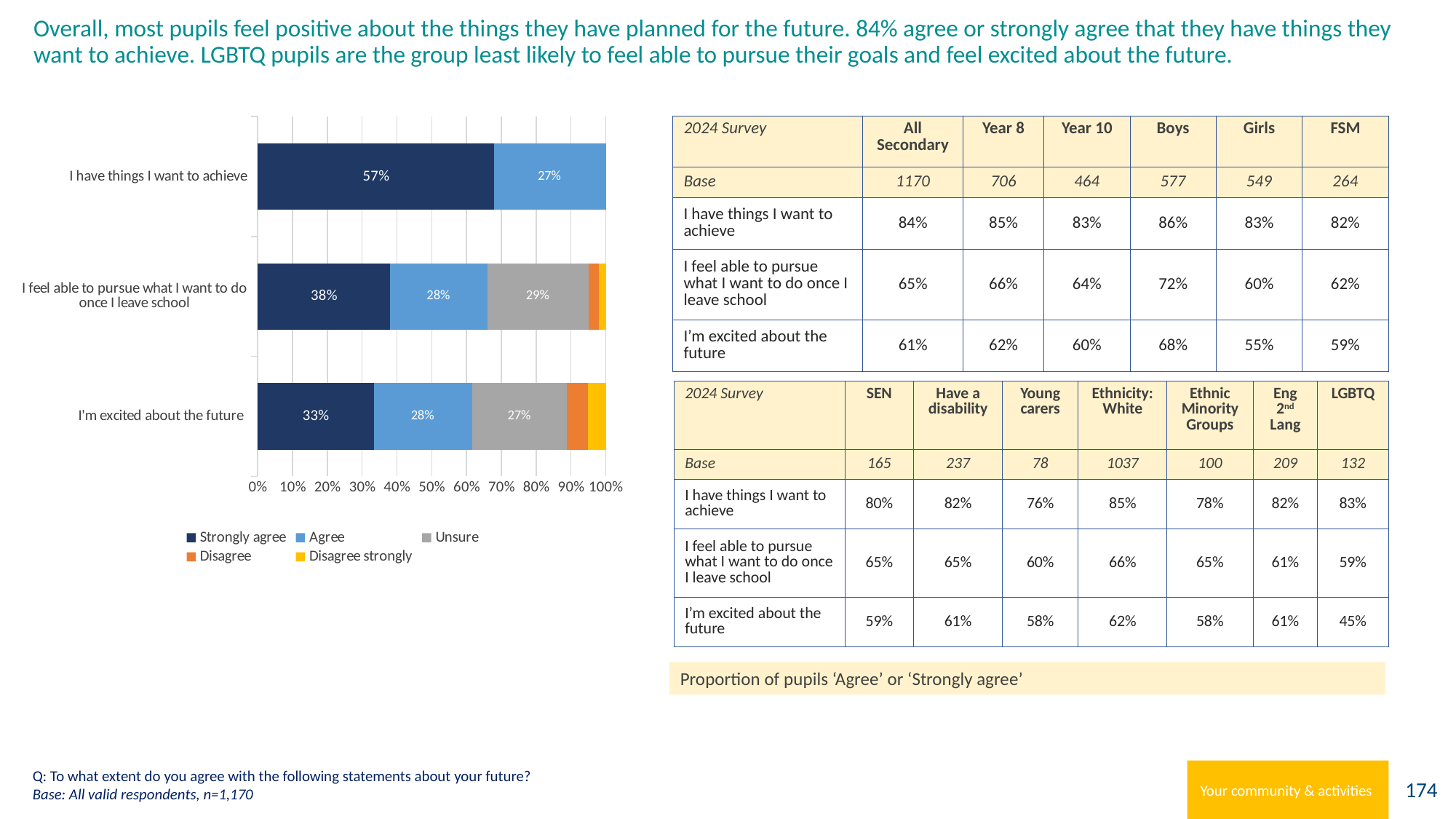
Which statement has the highest 'Strongly agree' value? I have things I want to achieve Is the 'Strongly agree' value for 'I have things I want to achieve' greater or less than 50%? greater How many series does the chart legend list? 5 Which statement has the lowest 'Strongly agree' value? I'm excited about the future What is the 'Strongly agree' value for 'I'm excited about the future'? 33% What percentage of pupils strongly agree that they have things they want to achieve? 57% What is the 'Unsure' value for 'I'm excited about the future'? 27% What is the difference between the 'Strongly agree' values for 'I have things I want to achieve' and 'I feel able to pursue what I want to do once I leave school'? 19 percentage points What is the 'Agree' value for 'I feel able to pursue what I want to do once I leave school'? 28% Is the 'Strongly agree' value larger for 'I feel able to pursue what I want to do once I leave school' or for 'I'm excited about the future'? I feel able to pursue what I want to do once I leave school How many statements are plotted in the chart? 3 What type of chart is shown on the slide? Stacked bar chart